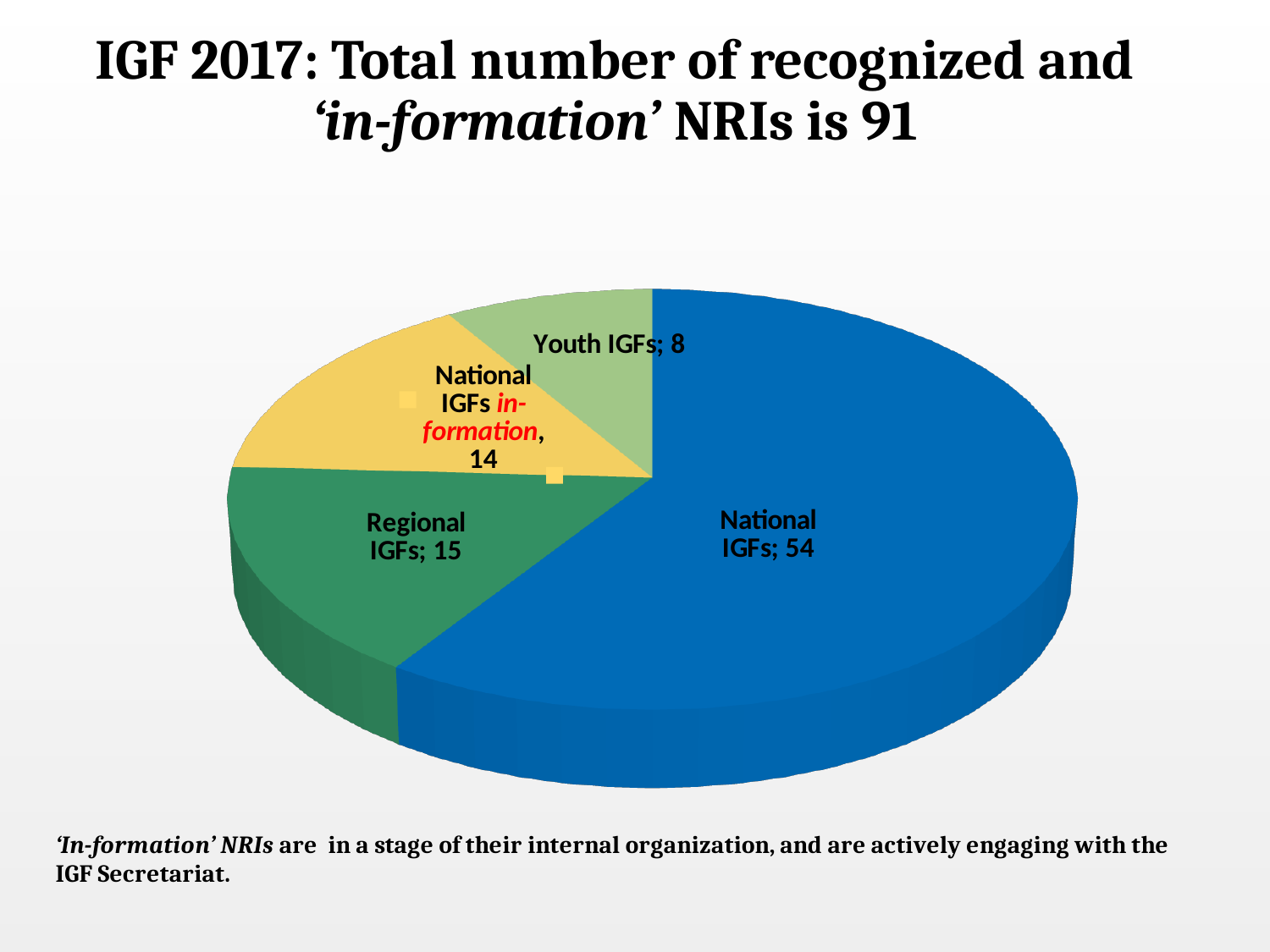
What is the value for Youth IGFs? 8 What is the value for Regional IGFs? 15 What is the value for National IGFs? 54 What is the total of all slices in the pie chart? 91 Which is larger, Regional IGFs or National IGFs in-formation? Regional IGFs Which category has the smallest slice of the pie? Youth IGFs What is the value for National IGFs in-formation? 14 Which category has the largest slice of the pie? National IGFs What colour is the National IGFs slice? Blue How many slices does the pie chart have? 4 What is the difference between the values for National IGFs and Regional IGFs? 39 What type of chart is shown on the slide? Pie chart